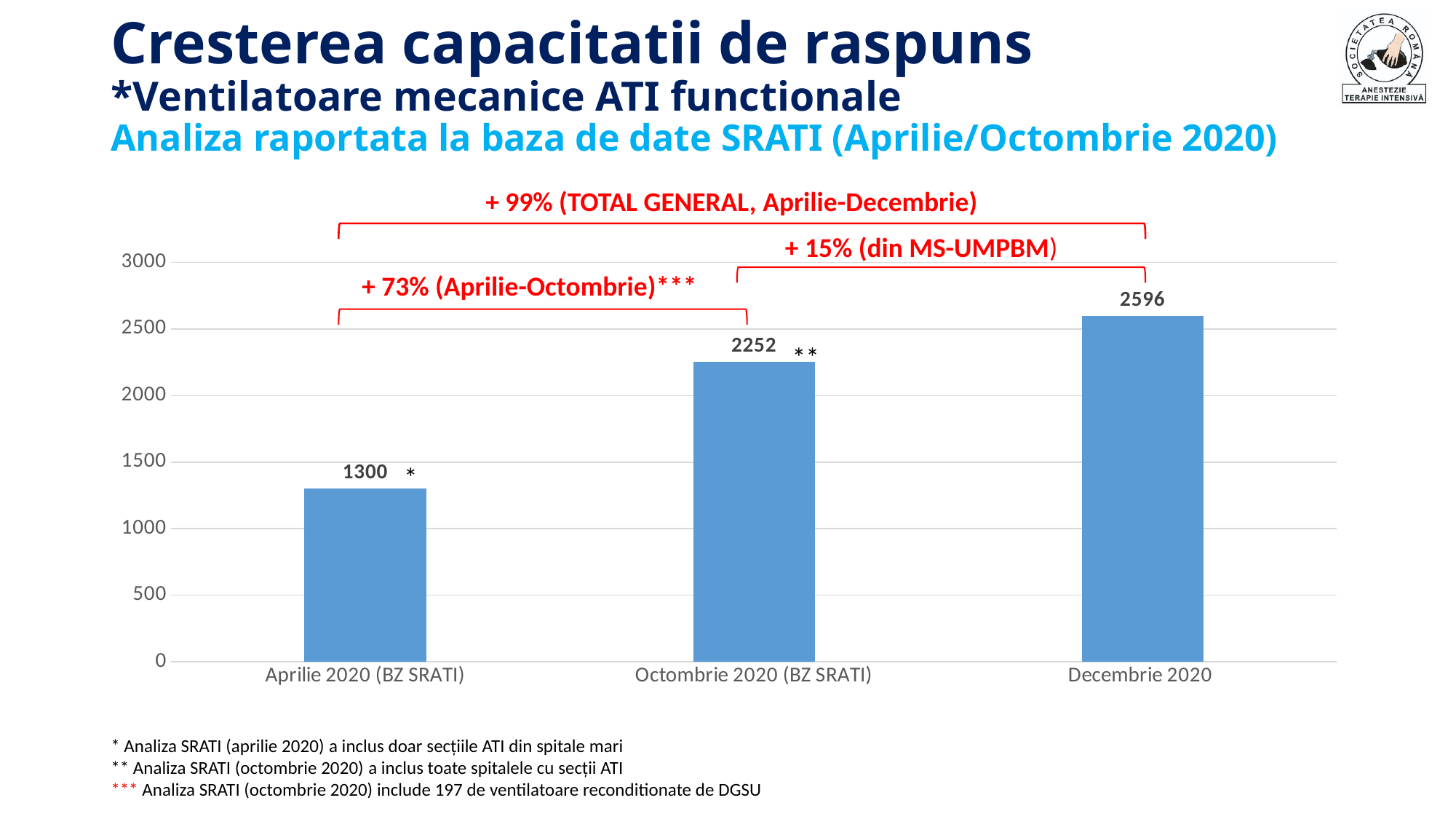
What is the difference between the values for Octombrie 2020 (BZ SRATI) and Aprilie 2020 (BZ SRATI)? 952 What is the value for Aprilie 2020 (BZ SRATI)? 1300 Is the value for Octombrie 2020 (BZ SRATI) greater or less than 2000? greater Do the values rise or fall from Aprilie 2020 to Decembrie 2020? rise How many categories are shown on the x axis? 3 Which is larger, the value for Octombrie 2020 (BZ SRATI) or Decembrie 2020? Decembrie 2020 What kind of chart is shown on the slide? bar chart What is the value for Decembrie 2020? 2596 Which category has the lowest value? Aprilie 2020 (BZ SRATI) Which category has the highest value? Decembrie 2020 What is the value for Octombrie 2020 (BZ SRATI)? 2252 What is the difference between the values for Decembrie 2020 and Aprilie 2020 (BZ SRATI)? 1296